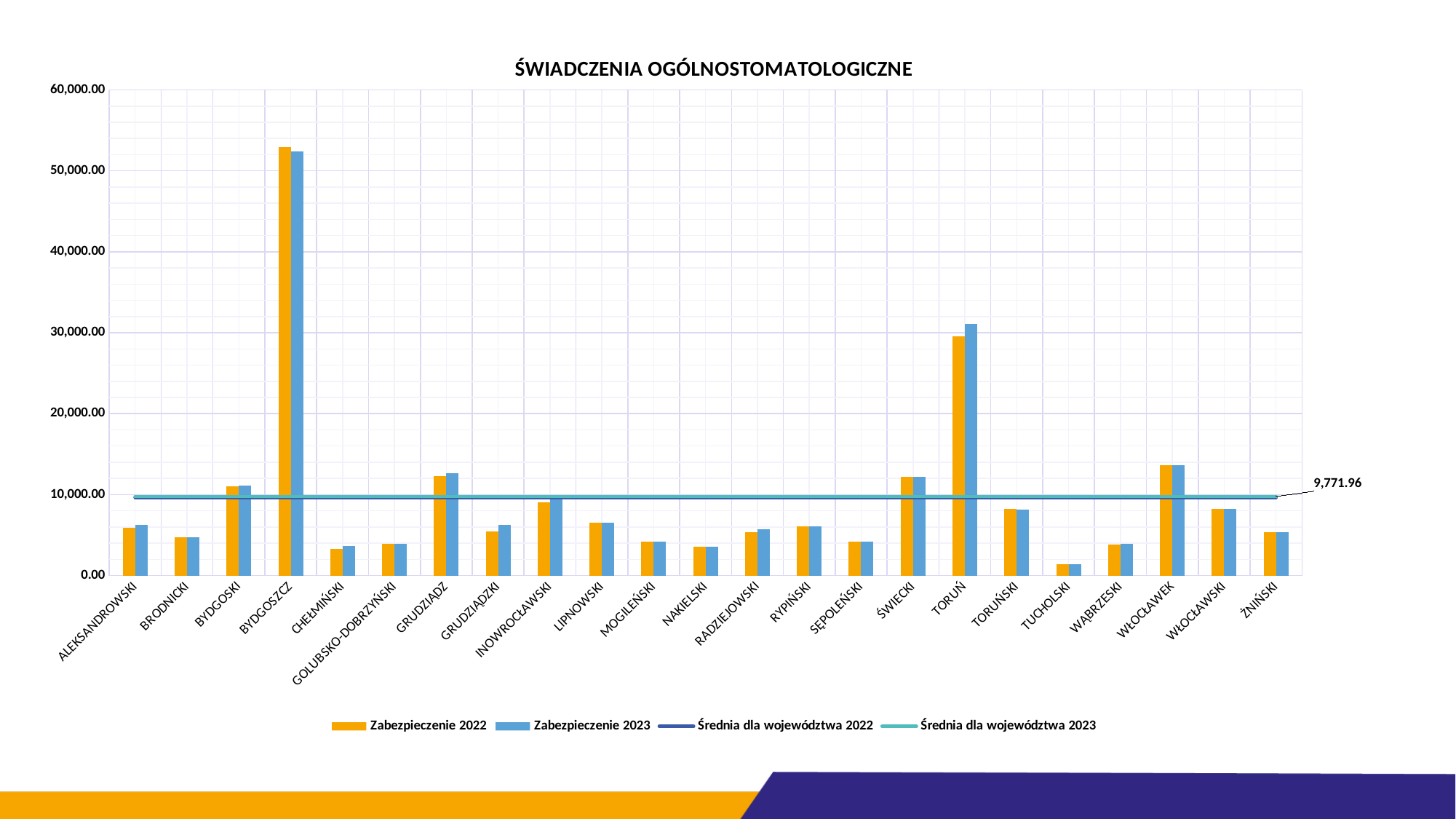
How many series does the legend list? 4 Which is larger for TORUŃ: the Zabezpieczenie 2022 value or the Zabezpieczenie 2023 value? Zabezpieczenie 2023 What value is printed at the right end of the Średnia dla województwa 2023 line? 9,771.96 Is the Zabezpieczenie 2022 value for CHEŁMIŃSKI greater or less than 10,000.00? less What kind of chart is shown on the slide? combination bar and line chart What is the title of the chart? ŚWIADCZENIA OGÓLNOSTOMATOLOGICZNE How many categories are shown on the x axis? 23 Is the Zabezpieczenie 2022 value for BYDGOSZCZ greater or less than 50,000.00? greater Which category has the lowest value for Zabezpieczenie 2023? TUCHOLSKI Which category has the larger Zabezpieczenie 2023 value: BYDGOSZCZ or TORUŃ? BYDGOSZCZ Is the Zabezpieczenie 2023 value for TORUŃ greater or less than 30,000.00? greater Which category has the highest value for Zabezpieczenie 2022? BYDGOSZCZ